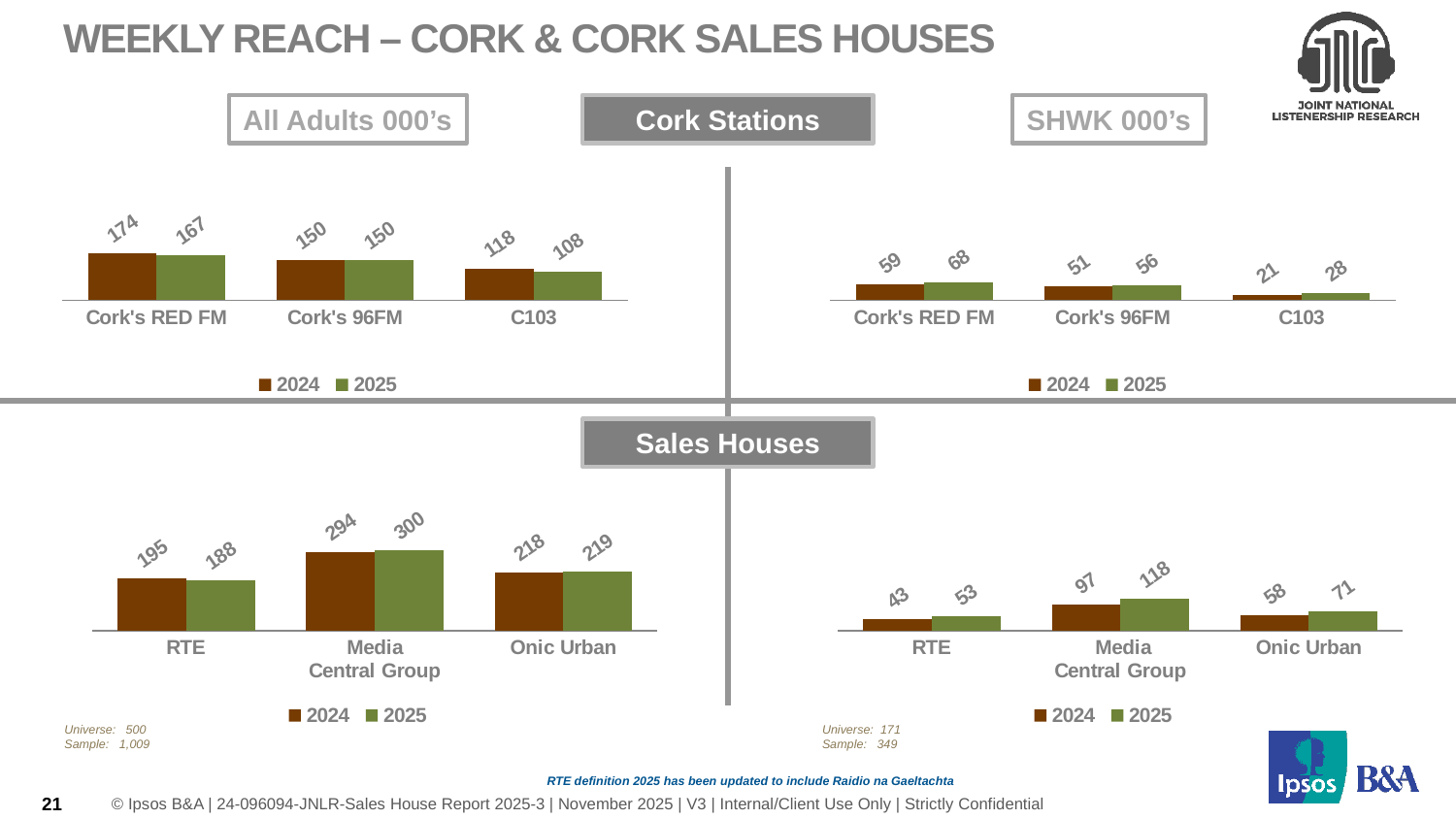
In the bottom-left Sales Houses All Adults 000's chart, what is the difference between the 2024 and 2025 values for RTE? 7 In the bottom-right Sales Houses SHWK 000's chart, what is the 2024 value for Onic Urban? 58 In the top-left Cork Stations All Adults 000's chart, which station has the highest 2024 value? Cork's RED FM In the top-left Cork Stations All Adults 000's chart, what is the 2024 value for C103? 118 In the top-right Cork Stations SHWK 000's chart, what is the 2025 value for Cork's 96FM? 56 In the bottom-left Sales Houses All Adults 000's chart, what is the 2025 value for Media Central Group? 300 In the top-left Cork Stations All Adults 000's chart, what is the difference between the 2024 and 2025 values for C103? 10 In the top-left Cork Stations All Adults 000's chart, what is the 2025 value for Cork's RED FM? 167 How many series does the legend list in the bottom-left Sales Houses All Adults 000's chart? 2 In the top-right Cork Stations SHWK 000's chart, is the 2025 value for Cork's RED FM larger than its 2024 value? Yes In the top-right Cork Stations SHWK 000's chart, which station has the lowest 2025 value? C103 In the bottom-right Sales Houses SHWK 000's chart, which sales house has the highest 2025 value? Media Central Group